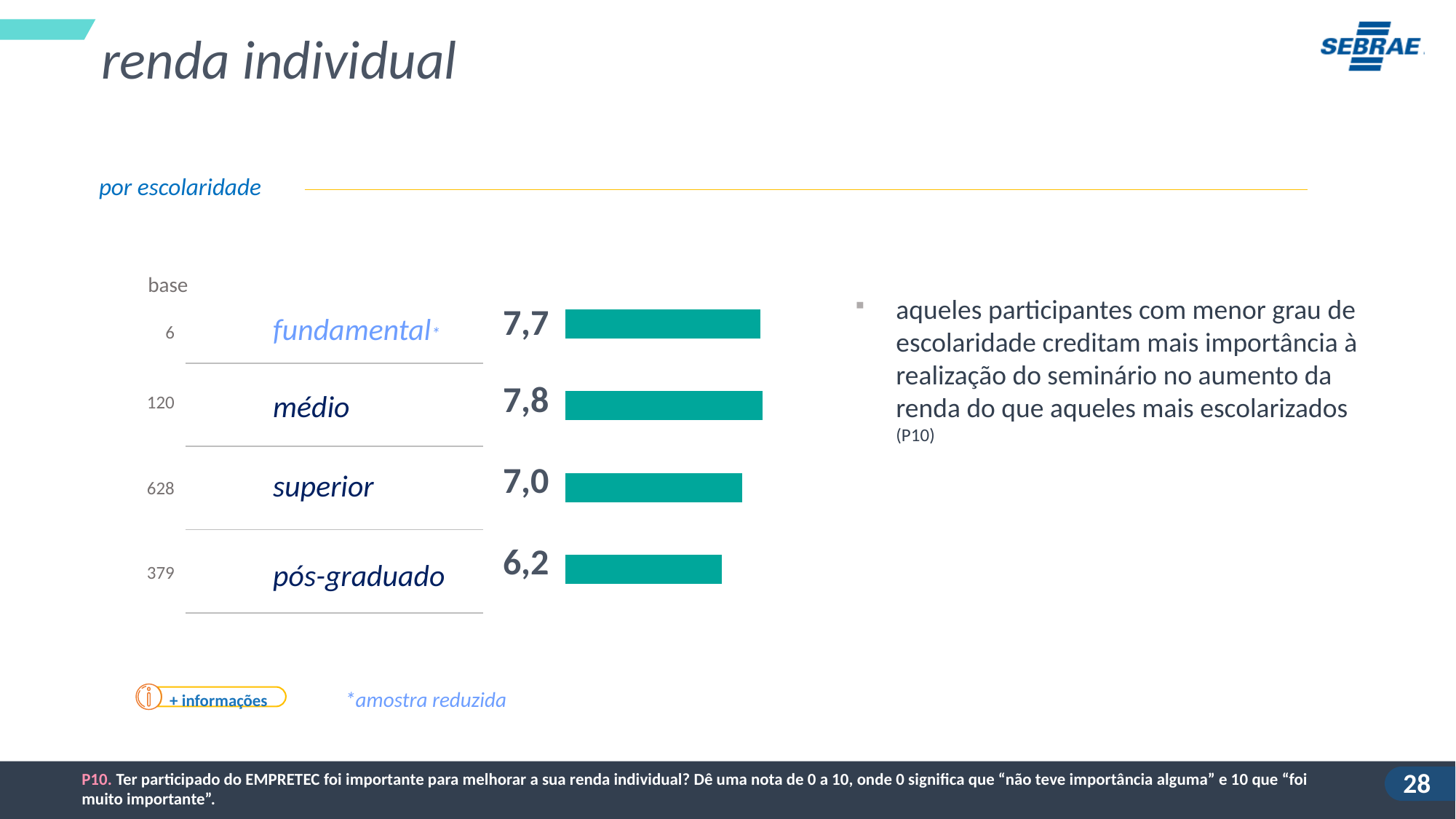
What is the base (sample size) shown for the superior category? 628 What kind of chart is shown on the slide? bar chart What is the value for fundamental? 7,7 Which is larger, the value for superior or the value for pós-graduado? superior What is the value for superior? 7,0 Which category has the highest value? médio Which category has the lowest value? pós-graduado What is the value for médio? 7,8 What is the difference between the values for fundamental and superior? 0,7 What is the value for pós-graduado? 6,2 What is the difference between the values for médio and pós-graduado? 1,6 How many categories are shown in the chart? 4